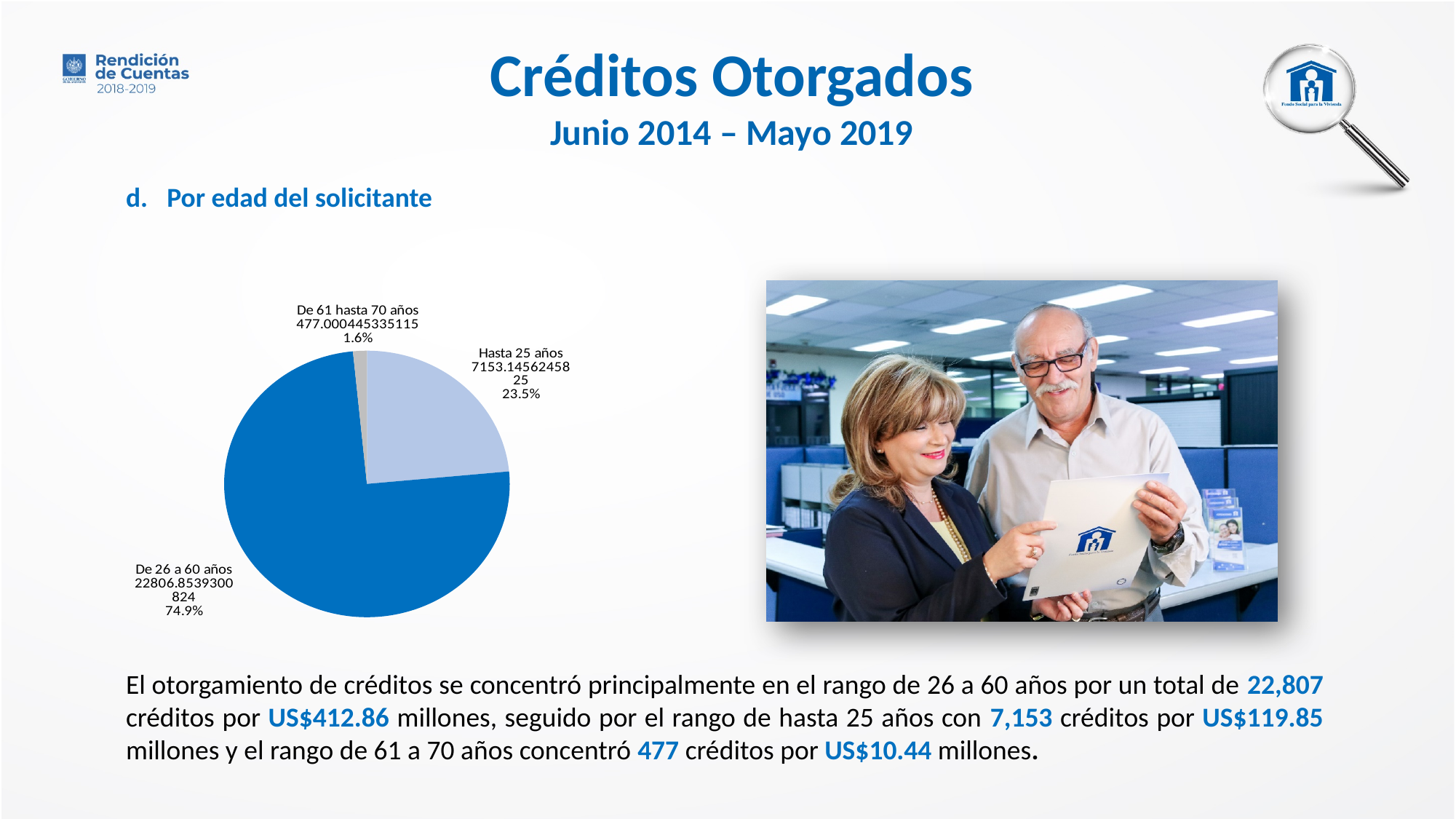
What percentage share does the 'De 26 a 60 años' slice have in the pie chart? 74.9% What percentage share does the 'Hasta 25 años' slice have in the pie chart? 23.5% Which age range has the largest slice in the pie chart? De 26 a 60 años What is the difference in percentage points between the 'Hasta 25 años' share and the 'De 61 hasta 70 años' share? 21.9 How many slices does the pie chart have? 3 What is the heading above the pie chart? d. Por edad del solicitante What kind of chart is shown on the slide? pie chart Which age range has the smallest slice in the pie chart? De 61 hasta 70 años What is the difference in percentage points between the 'De 26 a 60 años' share and the 'Hasta 25 años' share? 51.4 Which slice is larger in the pie chart, 'Hasta 25 años' or 'De 61 hasta 70 años'? Hasta 25 años What percentage share does the 'De 61 hasta 70 años' slice have in the pie chart? 1.6% What colour is the 'De 26 a 60 años' slice in the pie chart? dark blue